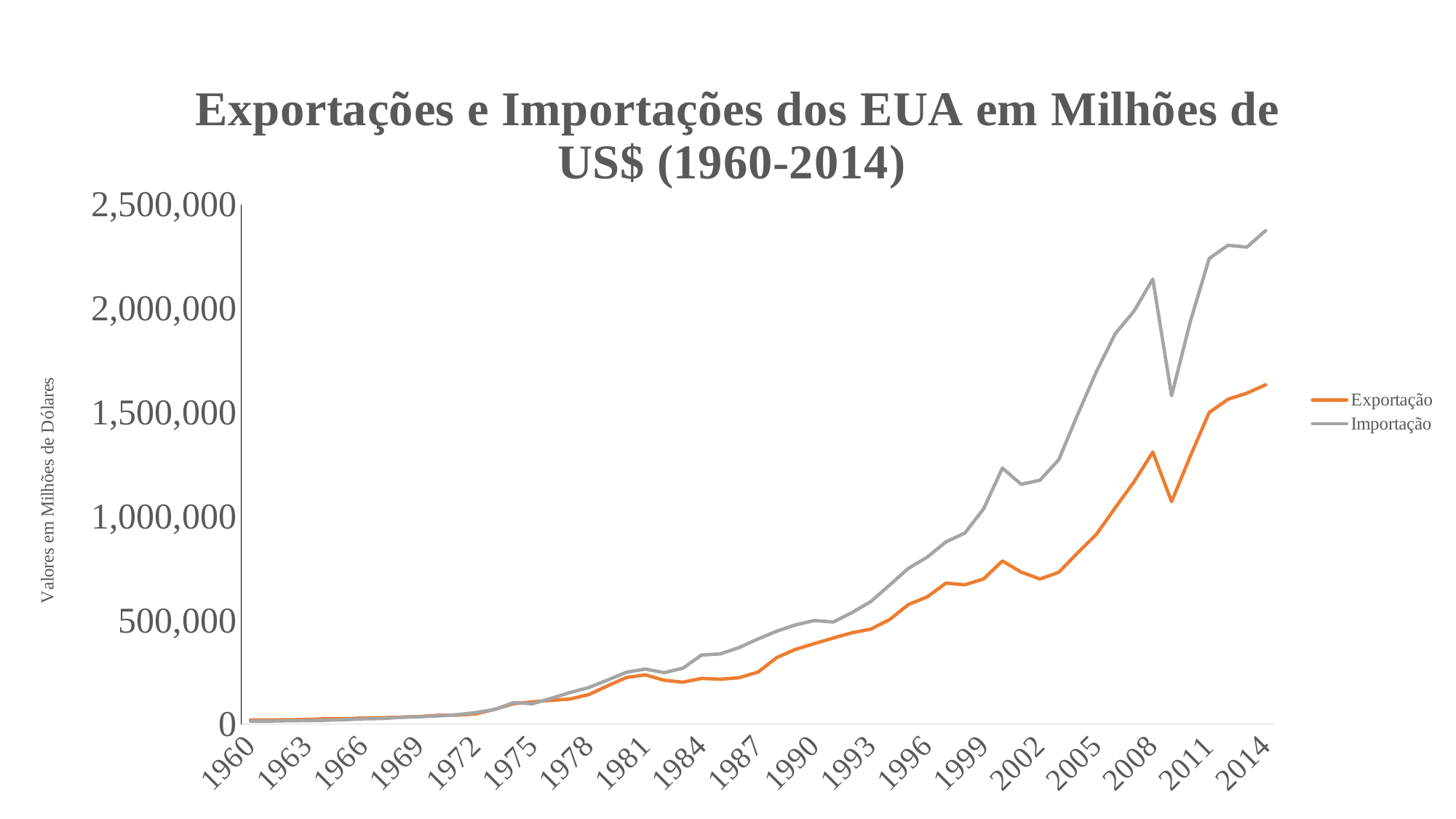
Is the value for Importação in 2014 greater or less than 2,000,000? greater Overall, do the Exportação values rise or fall from 1960 to 2014? rise Is the value for Importação in 2002 greater or less than 1,000,000? greater In 2014, which series has the larger value, Exportação or Importação? Importação What kind of chart is shown on the slide? line chart How many series does the legend list? 2 In which year does the Importação series reach its highest value? 2014 What is the title of the chart? Exportações e Importações dos EUA em Milhões de US$ (1960-2014) Is the value for Exportação in 1990 greater or less than 500,000? less What are the two series named in the legend? Exportação and Importação How many year labels are shown on the x axis? 19